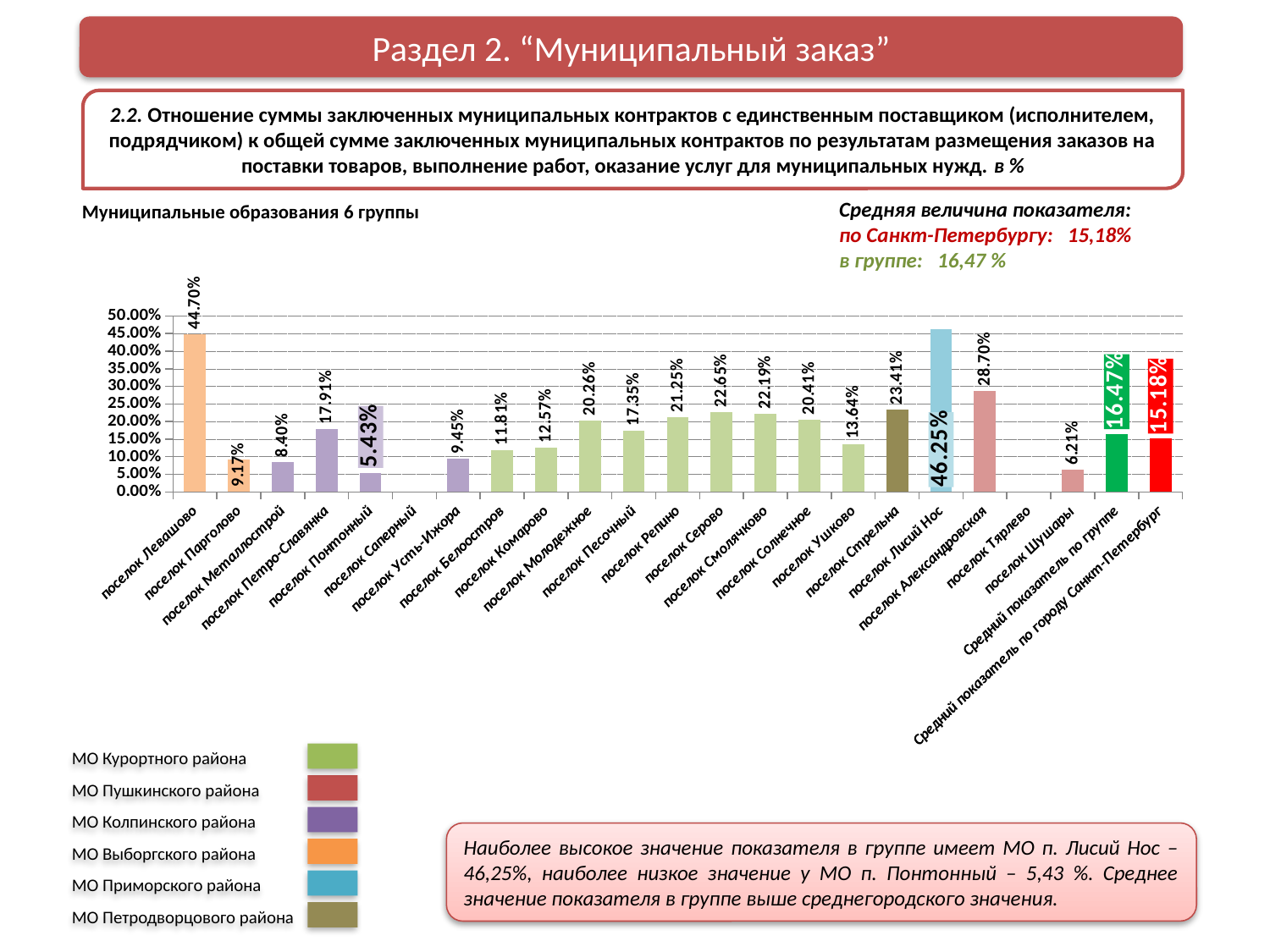
What is the value for поселок Александровская? 28.70% Which is larger, the value for поселок Стрельна or поселок Ушково? поселок Стрельна Which category has the highest value on the chart? поселок Лисий Нос What is the value for поселок Левашово? 44.70% Which is larger, the value for поселок Серово or поселок Смолячково? поселок Серово Which category with a plotted bar has the lowest value? поселок Понтонный What kind of chart is shown on the slide? bar chart How many categories are listed on the x axis of the chart? 23 What is the difference between Средний показатель по группе and Средний показатель по городу Санкт-Петербург? 1.29% What is the difference between the values for поселок Лисий Нос and поселок Левашово? 1.55% Which district group does the orange colour represent in the legend? МО Выборгского района What is the value shown for Средний показатель по группе? 16.47%